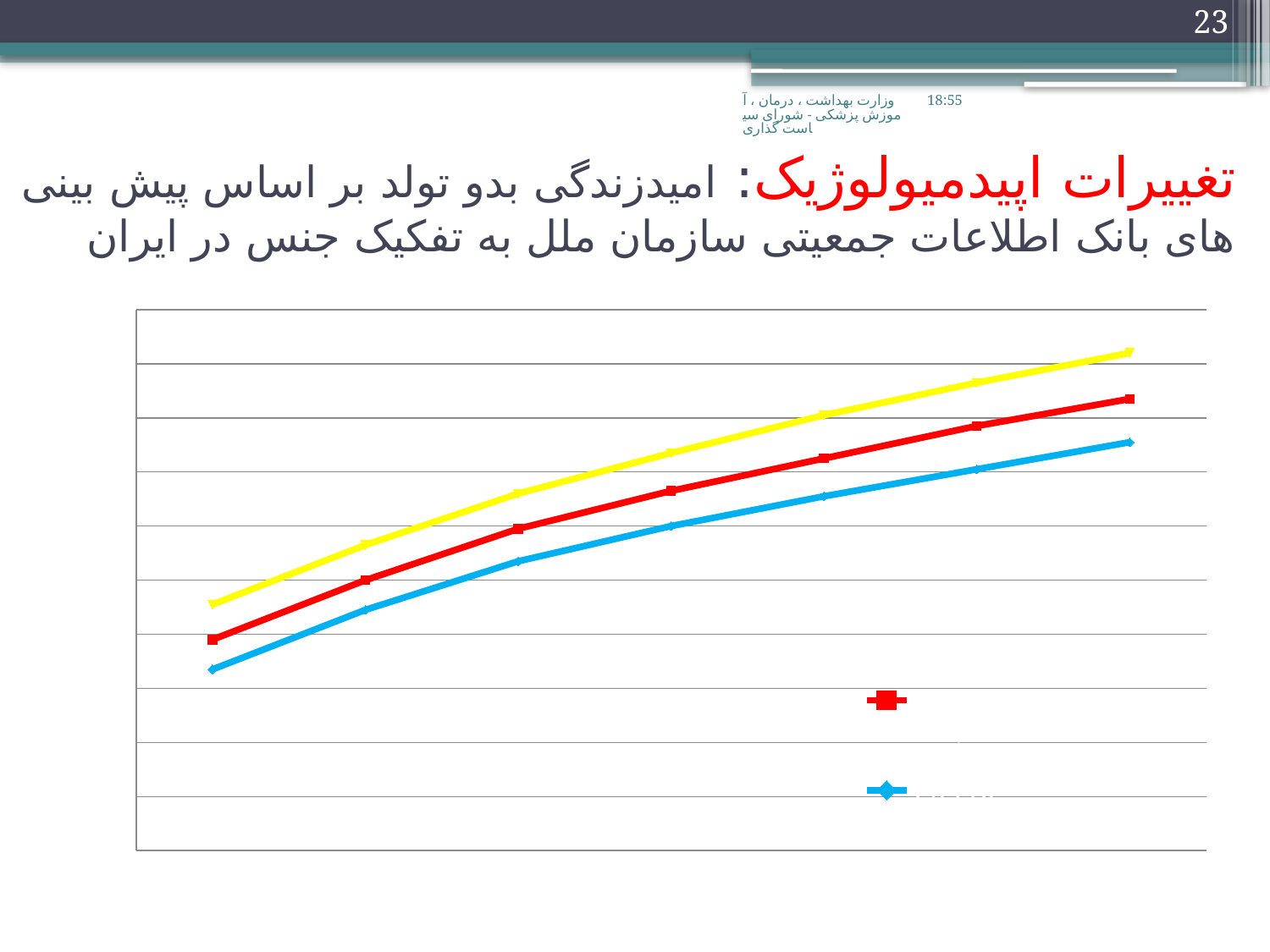
Does the gap between the yellow line and the blue line widen or narrow from left to right? widen Do the values of the lines rise or fall from left to right along the x axis? rise Which line is lowest on the chart: the yellow, red or blue line? blue How many lines are plotted on the chart? 3 Which line is highest on the chart: the yellow, red or blue line? yellow How many data points does each line on the chart have? 7 What kind of chart is shown on the slide? line chart Is the red line above or below the blue line across the chart? above What colours are the three lines on the chart? yellow, red and blue